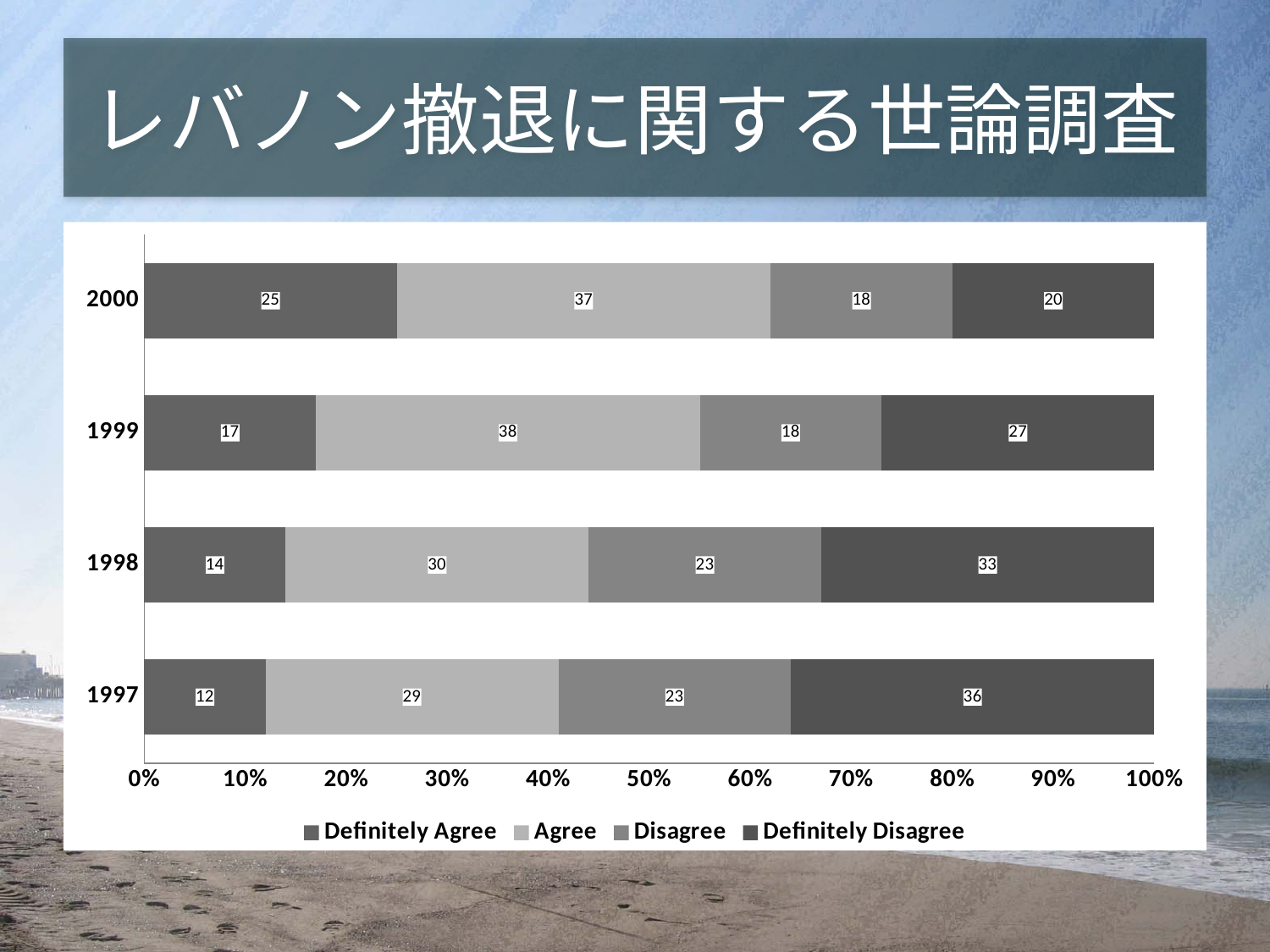
What is the value for Agree in 1999? 38 What kind of chart is shown on the slide? Stacked bar chart How many series does the legend list? 4 What is the value for Disagree in 1998? 23 What is the total of the stacked bar for 1999? 100 What is the difference between the Definitely Disagree values for 1997 and 2000? 16 How many years are shown on the chart? 4 Which is larger, the Agree value for 1998 or the Agree value for 1997? 1998 Which year has the lowest value for Definitely Disagree? 2000 Which year has the highest value for Definitely Agree? 2000 What is the value for Definitely Disagree in 1997? 36 What is the value for Definitely Agree in 2000? 25